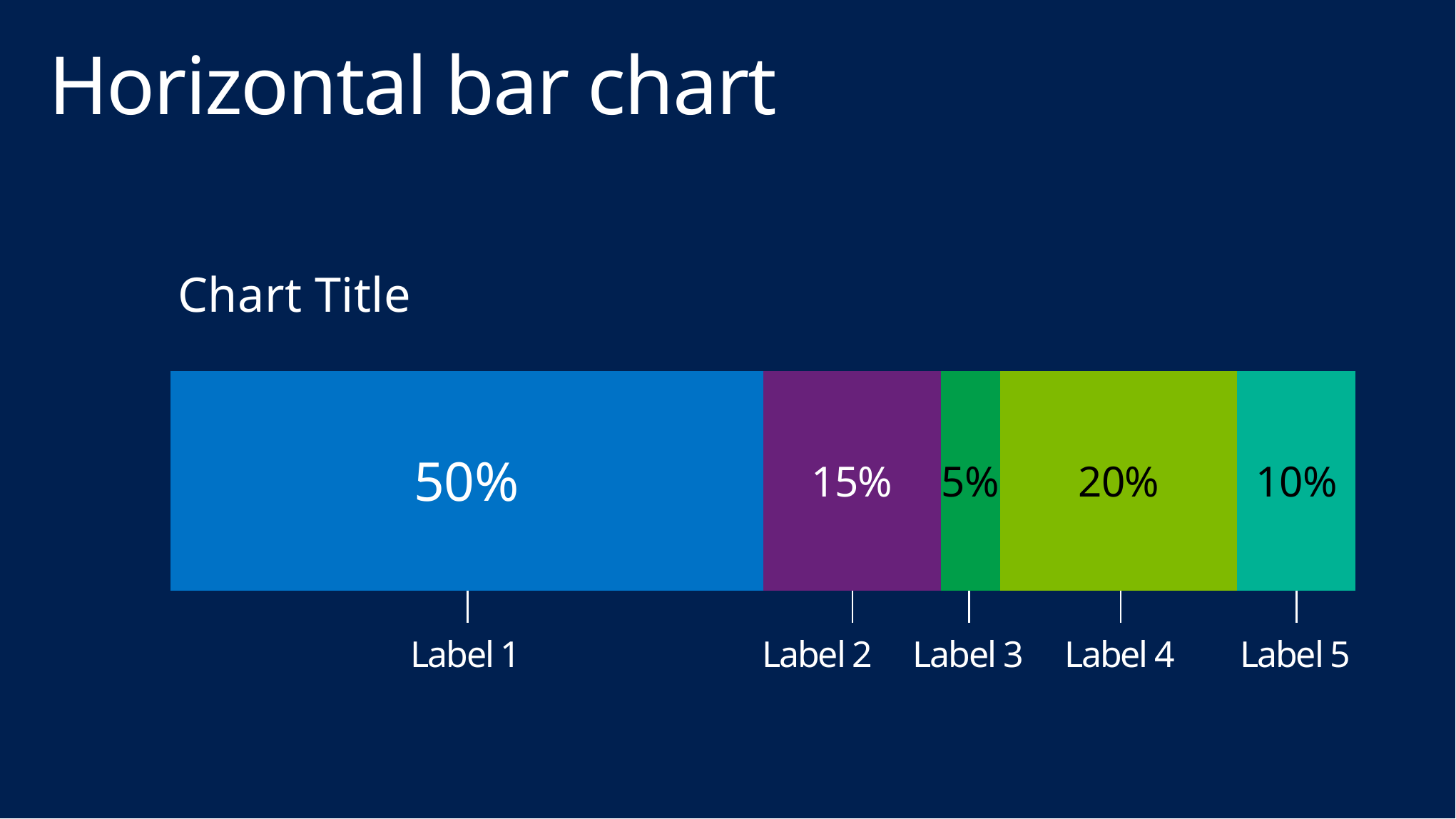
What is the value for Label 4? 20% How many labelled segments does the bar have? 5 What is the difference between the values for Label 1 and Label 4? 30% Which label has the highest value? Label 1 What is the value for Label 2? 15% What is the value for Label 1? 50% What is the title of the chart? Chart Title Which label has the lowest value? Label 3 What is the value for Label 3? 5% What is the value for Label 5? 10% What is the total of all the segments in the bar? 100% Which is larger, the value for Label 2 or the value for Label 5? Label 2